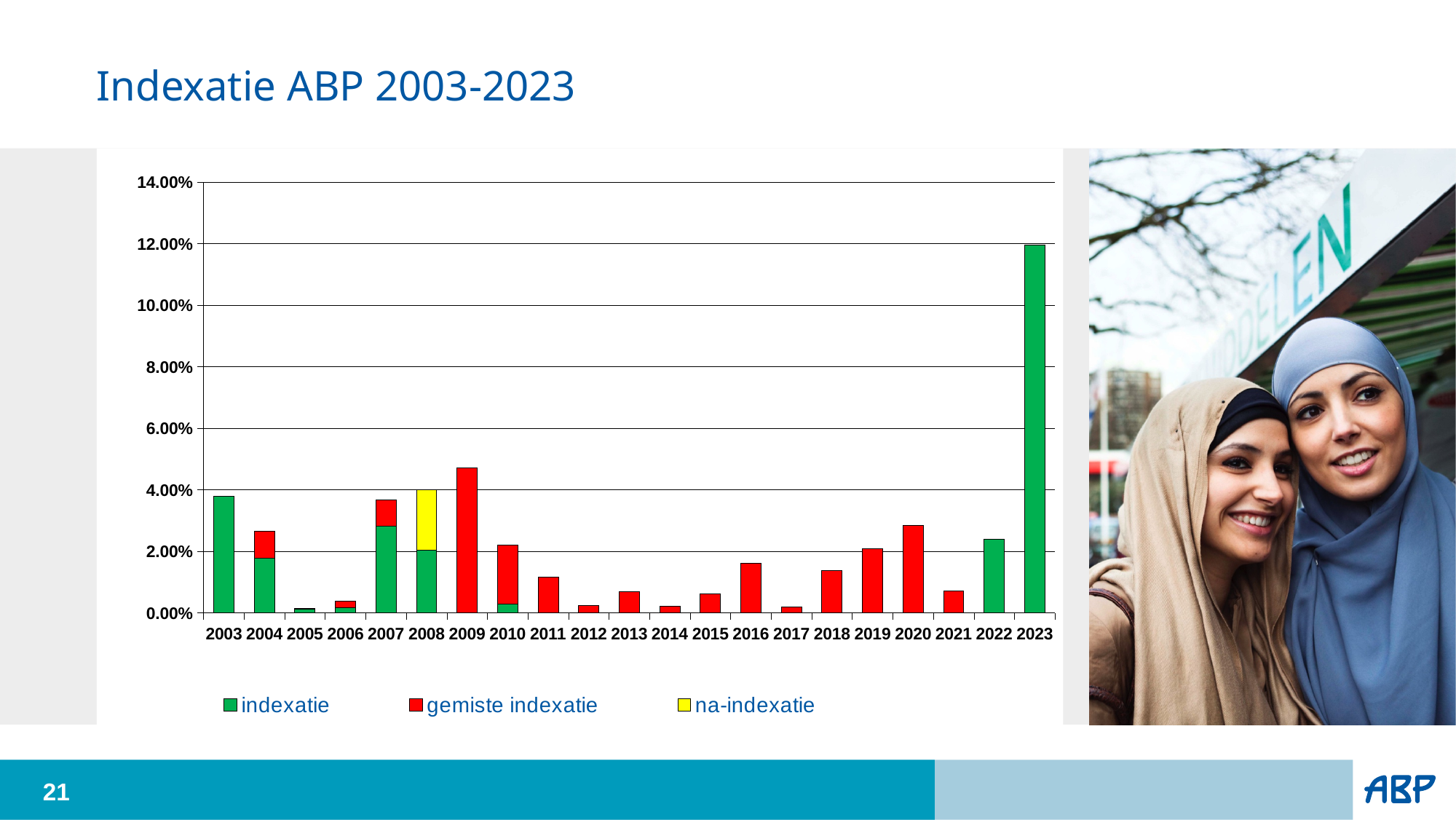
How many years are shown on the x axis? 21 Is the total bar for 2009 greater or less than 4.00%? greater Which year has the tallest bar? 2023 Is the total bar for 2020 greater or less than 2.00%? greater Which year is the only one with a 'na-indexatie' (yellow) segment? 2008 What colour represents 'gemiste indexatie' in the legend? red How many series does the legend list? 3 Is the total bar for 2016 greater or less than 2.00%? less Which total bar is taller, 2009 or 2007? 2009 What kind of chart is shown on the slide? bar chart